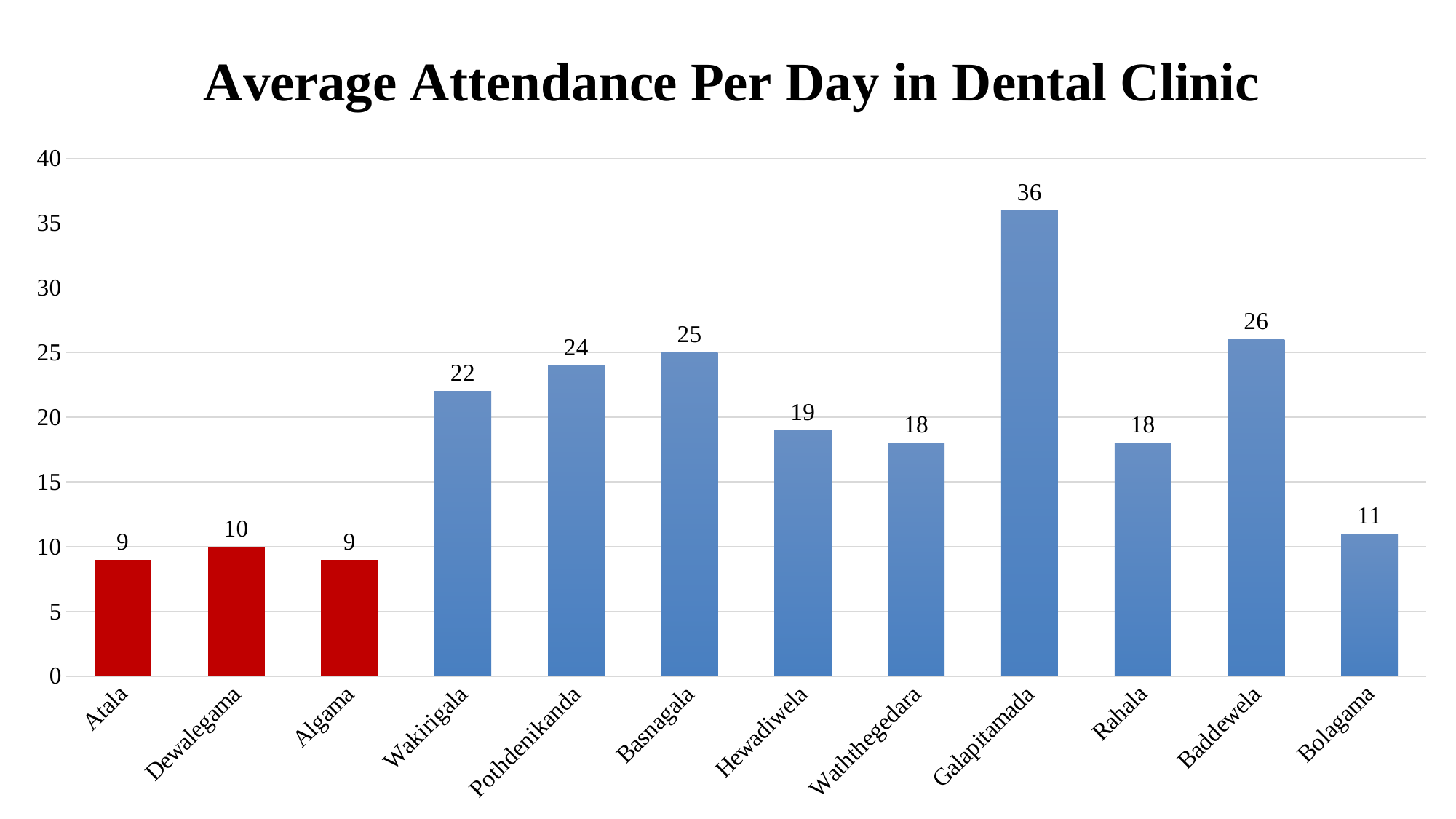
Which has a higher average attendance per day, Baddewela or Basnagala? Baddewela How many clinics are shown on the chart? 12 What is the difference in average attendance per day between Basnagala and Dewalegama? 15 What type of chart is shown on the slide? Bar chart Which has a higher average attendance per day, Wakirigala or Hewadiwela? Wakirigala What is the average attendance per day for Bolagama? 11 What is the title of the chart? Average Attendance Per Day in Dental Clinic Which clinic has the highest average attendance per day? Galapitamada What is the average attendance per day for Galapitamada? 36 What is the average attendance per day for Pothdenikanda? 24 Which clinics are shown with red bars? Atala, Dewalegama, Algama What is the difference in average attendance per day between Galapitamada and Baddewela? 10